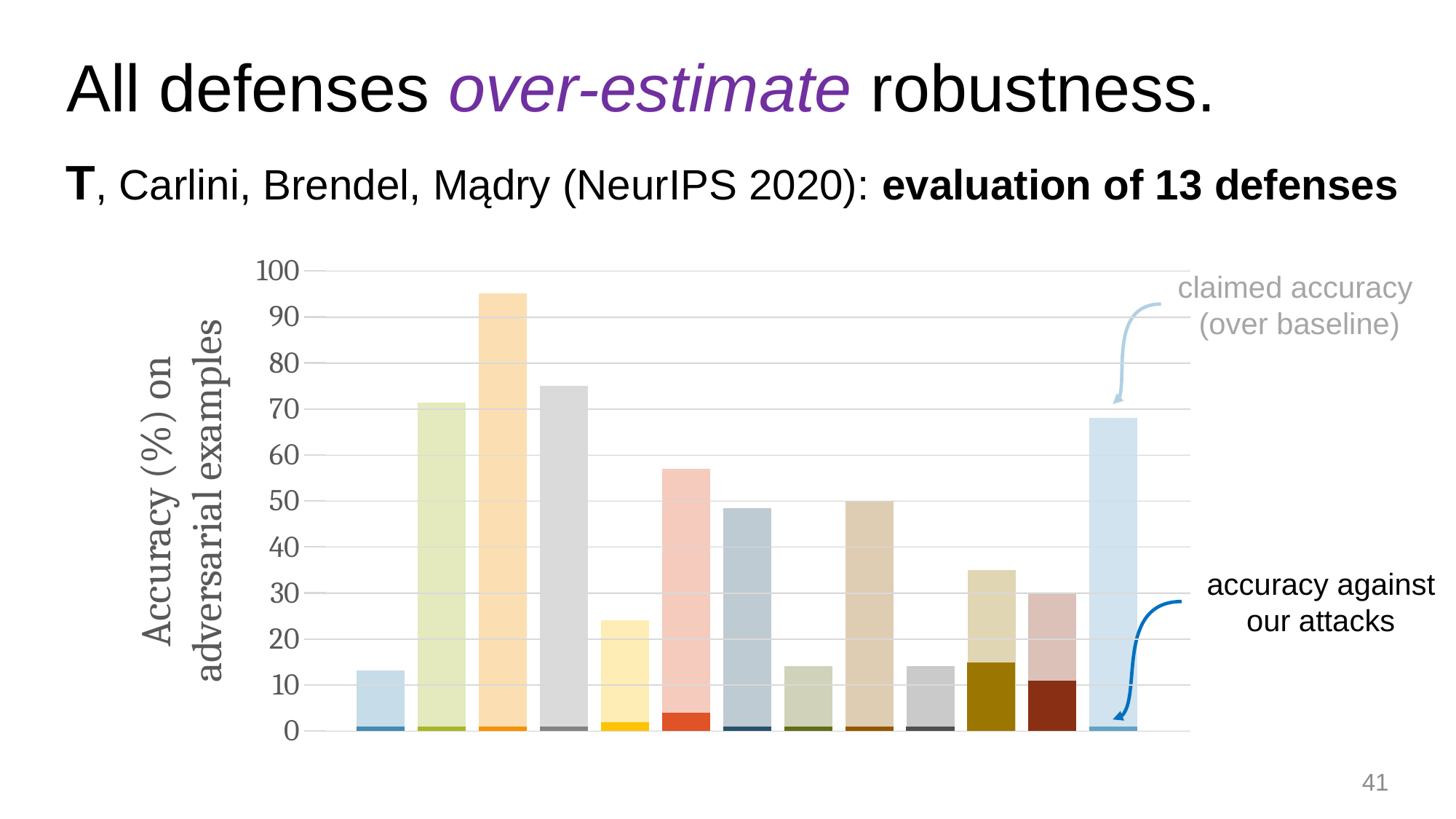
Which has the higher claimed accuracy: the fifth bar from the left or the sixth bar from the left? the sixth bar from the left Is the claimed accuracy of the first bar from the left greater or less than 20? less Which has the higher claimed accuracy: the third bar from the left or the rightmost bar? the third bar from the left What is the label of the y-axis of the chart? Accuracy (%) on adversarial examples Is the claimed accuracy of the rightmost bar greater or less than 60? greater What kind of chart is shown on the slide? bar chart Which bar, counting from the left, has the highest claimed accuracy? the third bar Is the claimed accuracy of the third bar from the left greater or less than 90? greater How many bars (defenses) are plotted in the chart? 13 According to the annotations, what does the light (taller) portion of each bar represent? claimed accuracy (over baseline)